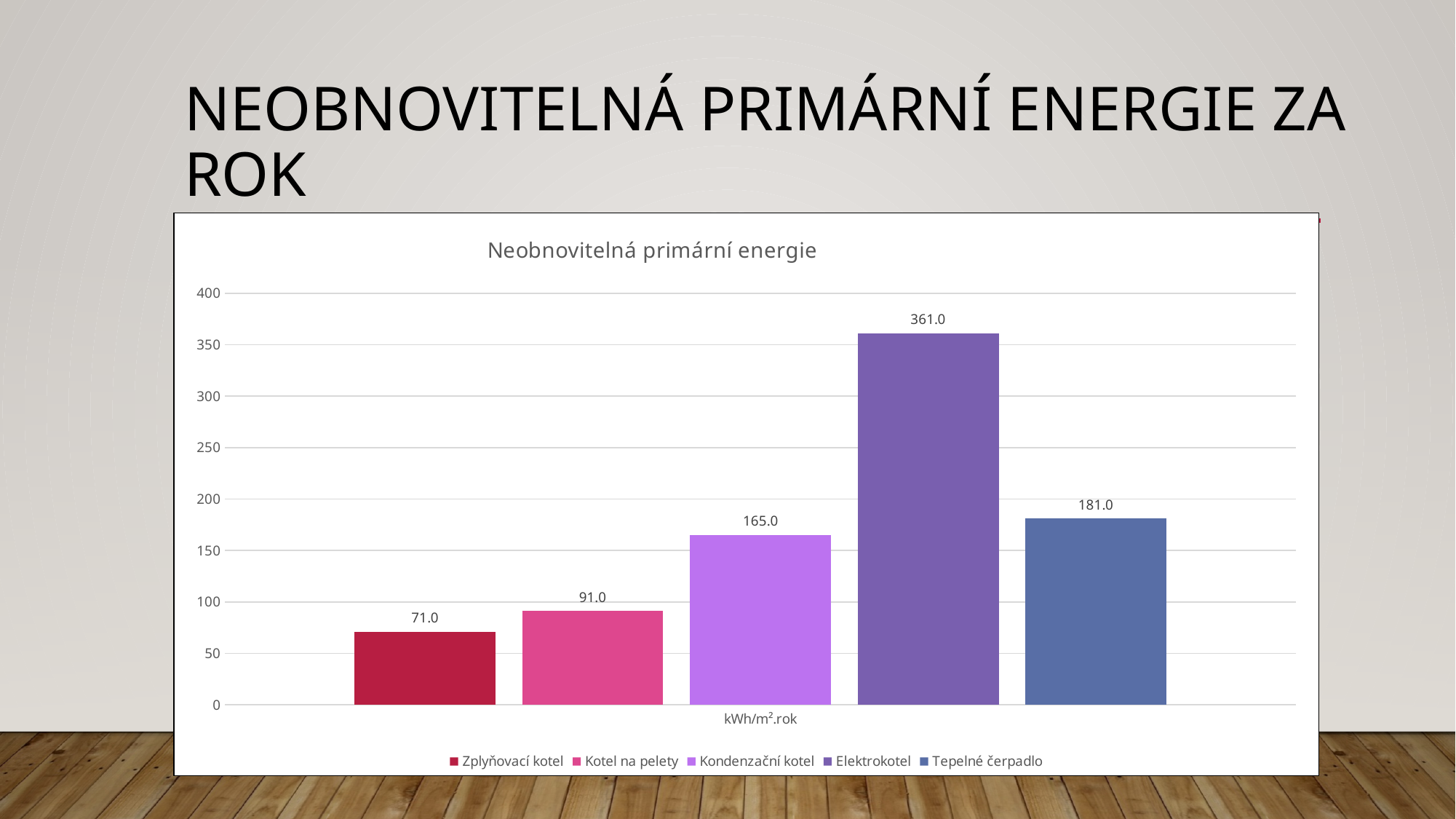
How many series does the legend list? 5 Which series has the lowest value? Zplyňovací kotel What is the value for Tepelné čerpadlo? 181.0 Which series has the highest value? Elektrokotel What kind of chart is shown? bar chart Is the value for Kondenzační kotel greater or less than 150? greater What is the title of the chart? Neobnovitelná primární energie What is the value for Elektrokotel? 361.0 What is the difference between the values for Elektrokotel and Tepelné čerpadlo? 180.0 What is the value for Zplyňovací kotel? 71.0 What is the difference between the values for Kotel na pelety and Zplyňovací kotel? 20.0 Which is larger, the value for Kondenzační kotel or the value for Tepelné čerpadlo? Tepelné čerpadlo